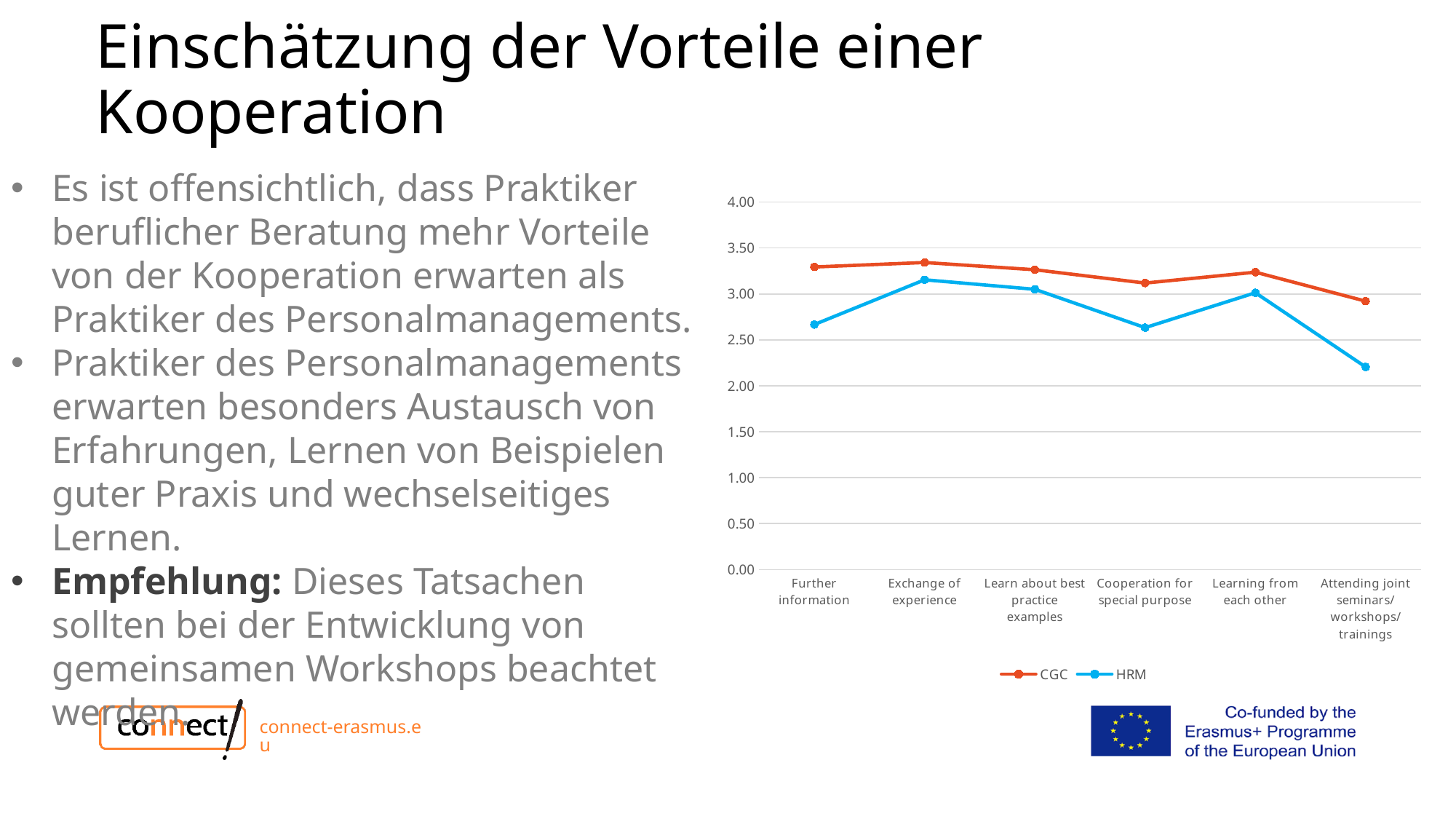
How many series does the chart legend list? 2 What are the two series names listed in the chart legend? CGC and HRM Is the HRM value for Attending joint seminars/workshops/trainings greater or less than 2.50? less Does the HRM line rise or fall from Learning from each other to Attending joint seminars/workshops/trainings? fall For which category is the HRM value lowest? Attending joint seminars/workshops/trainings How many categories are shown along the x axis of the chart? 6 Is the HRM value for Further information greater or less than 2.50? greater Is the CGC value for Exchange of experience greater or less than 3.50? less Which series has the higher value for Further information, CGC or HRM? CGC For which category is the CGC value lowest? Attending joint seminars/workshops/trainings Which series has the lower value for Attending joint seminars/workshops/trainings, CGC or HRM? HRM What kind of chart is shown on the slide? line chart